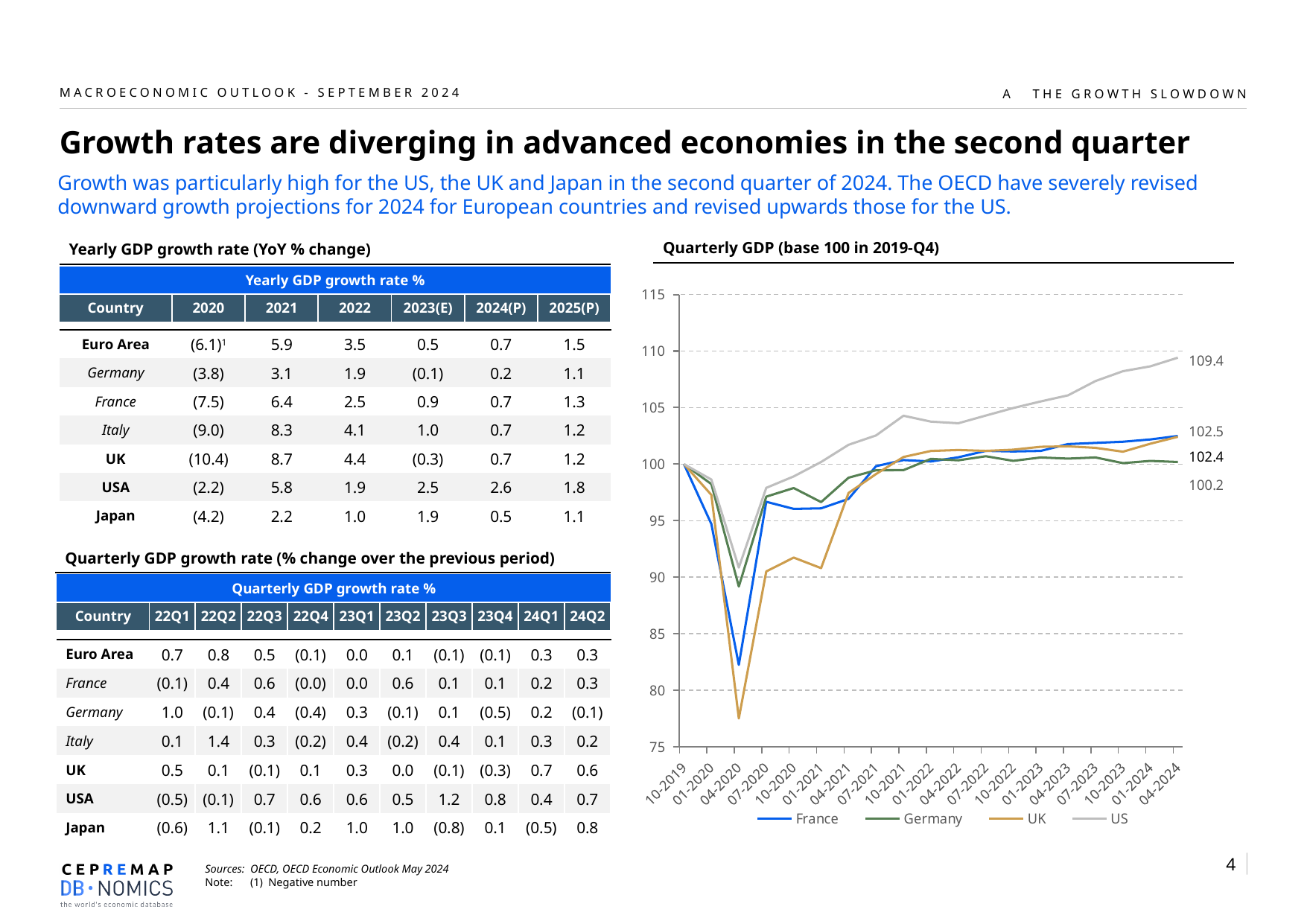
How many series does the legend of the Quarterly GDP chart list? 4 What is the title of the chart on the slide? Quarterly GDP (base 100 in 2019-Q4) Which series in the Quarterly GDP chart ends highest at 04-2024? US Which series in the Quarterly GDP chart falls to the lowest point in 04-2020? UK In the Quarterly GDP chart, what is the value of the Germany series at the last point (04-2024)? 100.2 Is the value for the US in 04-2020 greater or less than 95? less Which series in the Quarterly GDP chart ends lowest at 04-2024? Germany Is the value for the UK in 04-2020 greater or less than 80? less What kind of chart is shown on the slide? line chart In the Quarterly GDP chart, what is the value of the US series at the last point (04-2024)? 109.4 How many quarterly points are labelled on the x axis of the Quarterly GDP chart? 19 Is the value for the US in 01-2024 greater or less than 105? greater